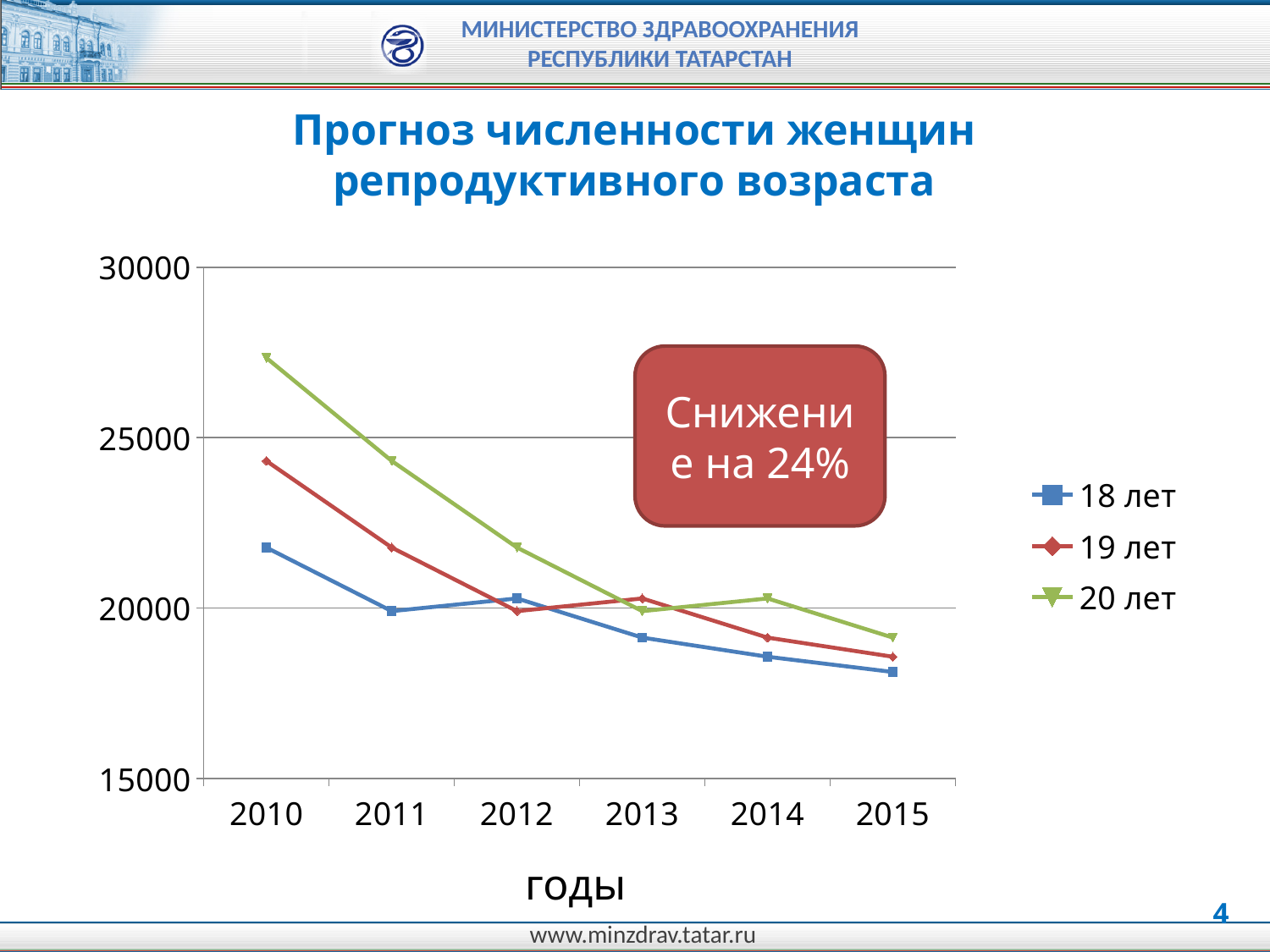
Is the value for 20 лет in 2012 greater or less than 20000? greater What percentage decrease is stated in the callout box on the chart? 24% What kind of chart is shown on the slide? line chart Which is larger in 2011: the value for 20 лет or the value for 18 лет? 20 лет Which series has the lowest value in 2010? 18 лет Is the value for 20 лет in 2010 greater or less than 25000? greater Is the value for 19 лет in 2015 greater or less than 20000? less How many years are shown on the x axis? 6 Which series has the highest value in 2010? 20 лет Does the 20 лет series rise or fall from 2010 to 2015? fall How many series does the legend list? 3